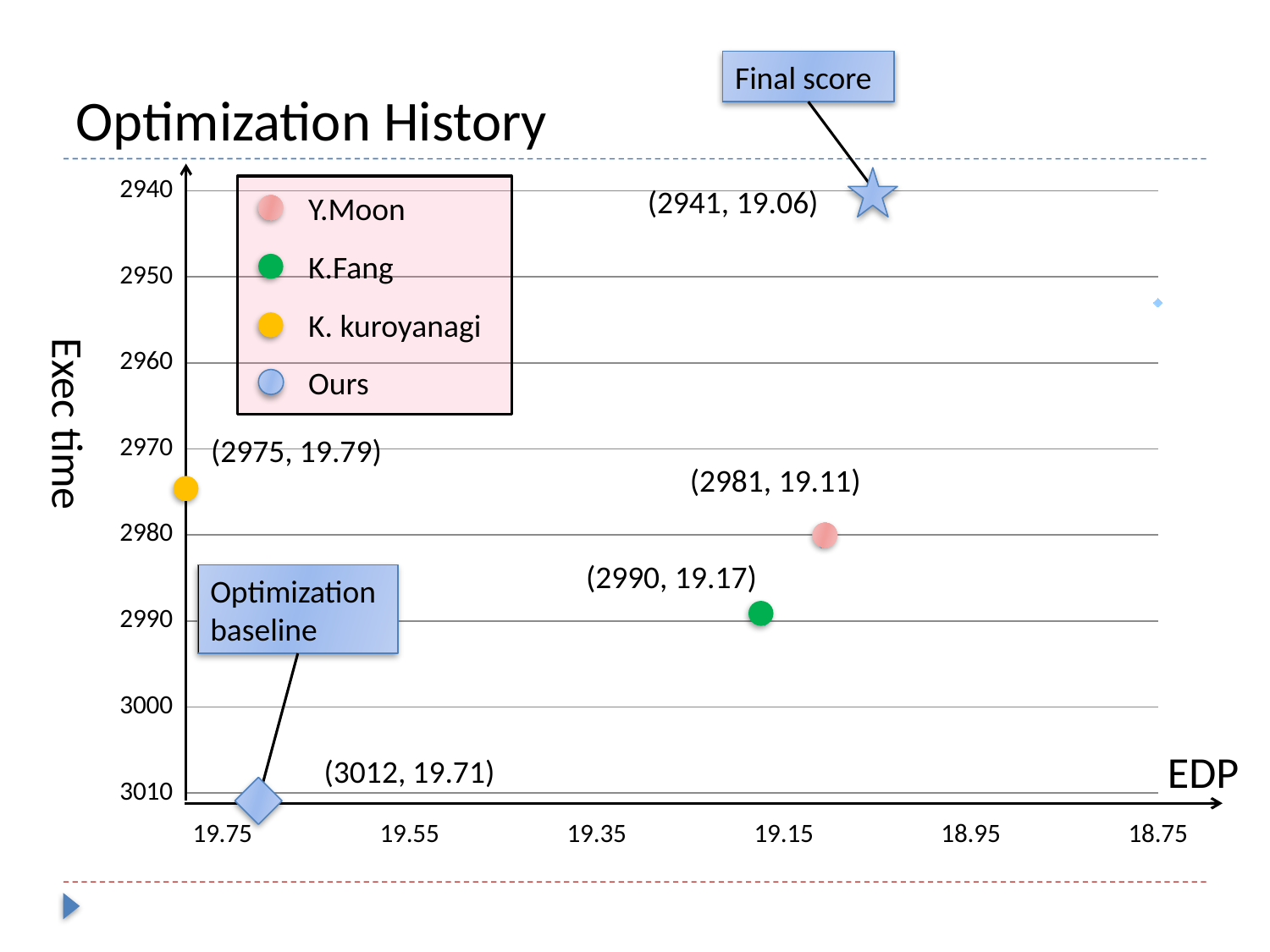
Which point has the highest exec time value? Optimization baseline, 3012 What are the labelled coordinates of the point marked as the Final score? (2941, 19.06) What are the labelled coordinates of the Optimization baseline point? (3012, 19.71) How many series does the legend list? 4 What are the labelled coordinates of the K.Fang point? (2990, 19.17) How many data points are plotted on the chart? 6 Which has the larger exec time value, the K.Fang point or the Y.Moon point? K.Fang What are the labelled coordinates of the Y.Moon point? (2981, 19.11) What is the title of the chart? Optimization History What type of chart is shown on the slide? scatter chart What is the difference in exec time between the K.Fang point and the Y.Moon point? 9 Which point has the lowest exec time value? Final score (Ours), 2941